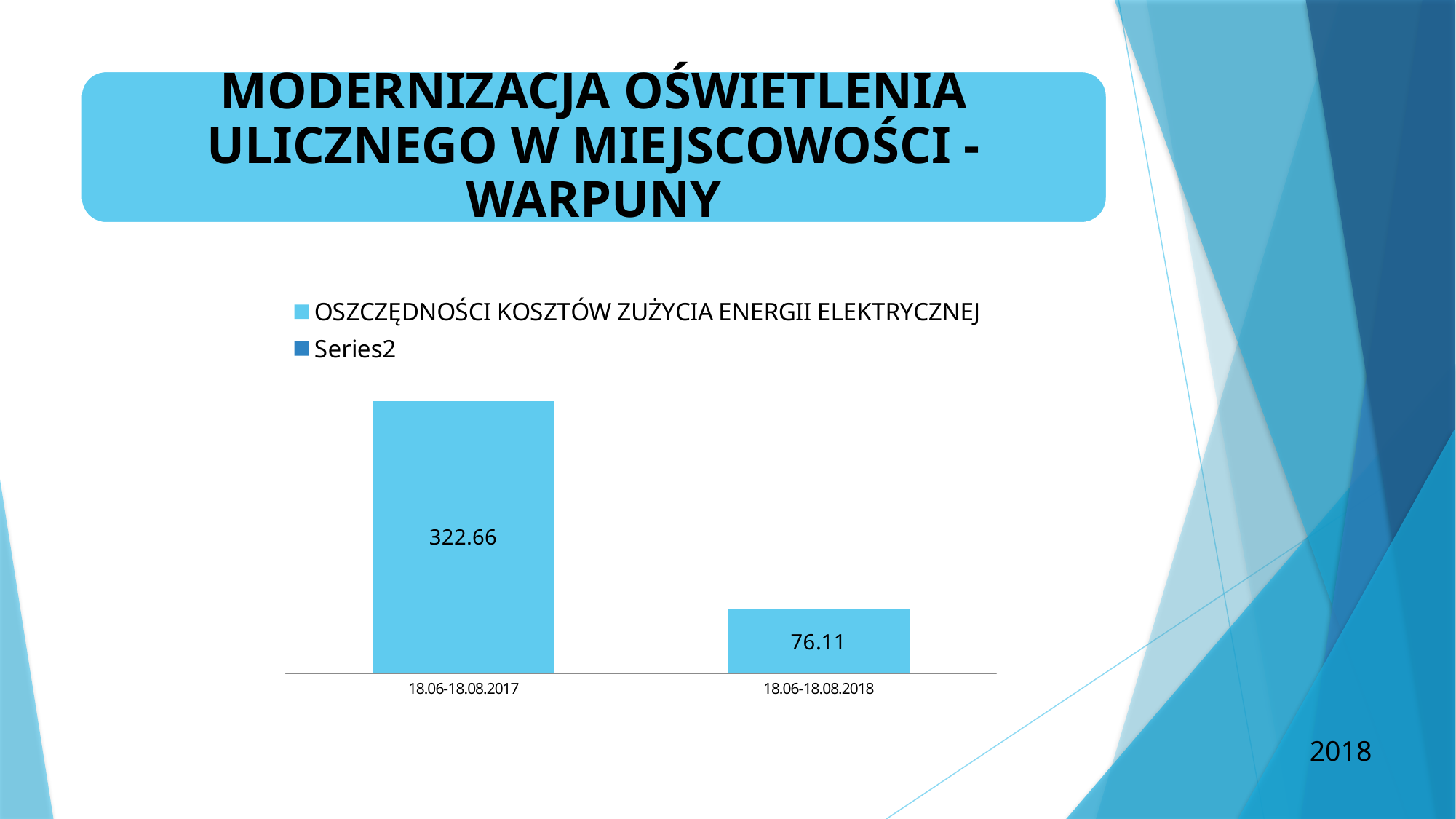
What is the difference between the values for 18.06-18.08.2017 and 18.06-18.08.2018? 246.55 What is the second legend entry of the chart? Series2 What is the value for 18.06-18.08.2018? 76.11 What is the value for 18.06-18.08.2017? 322.66 Which category has the lowest value? 18.06-18.08.2018 Which is larger, the value for 18.06-18.08.2017 or for 18.06-18.08.2018? 18.06-18.08.2017 What is the first legend entry of the chart? OSZCZĘDNOŚCI KOSZTÓW ZUŻYCIA ENERGII ELEKTRYCZNEJ How many categories are shown on the x axis? 2 What kind of chart is shown on the slide? bar chart Which category has the highest value? 18.06-18.08.2017 Do the values rise or fall from 18.06-18.08.2017 to 18.06-18.08.2018? fall How many series does the legend list? 2